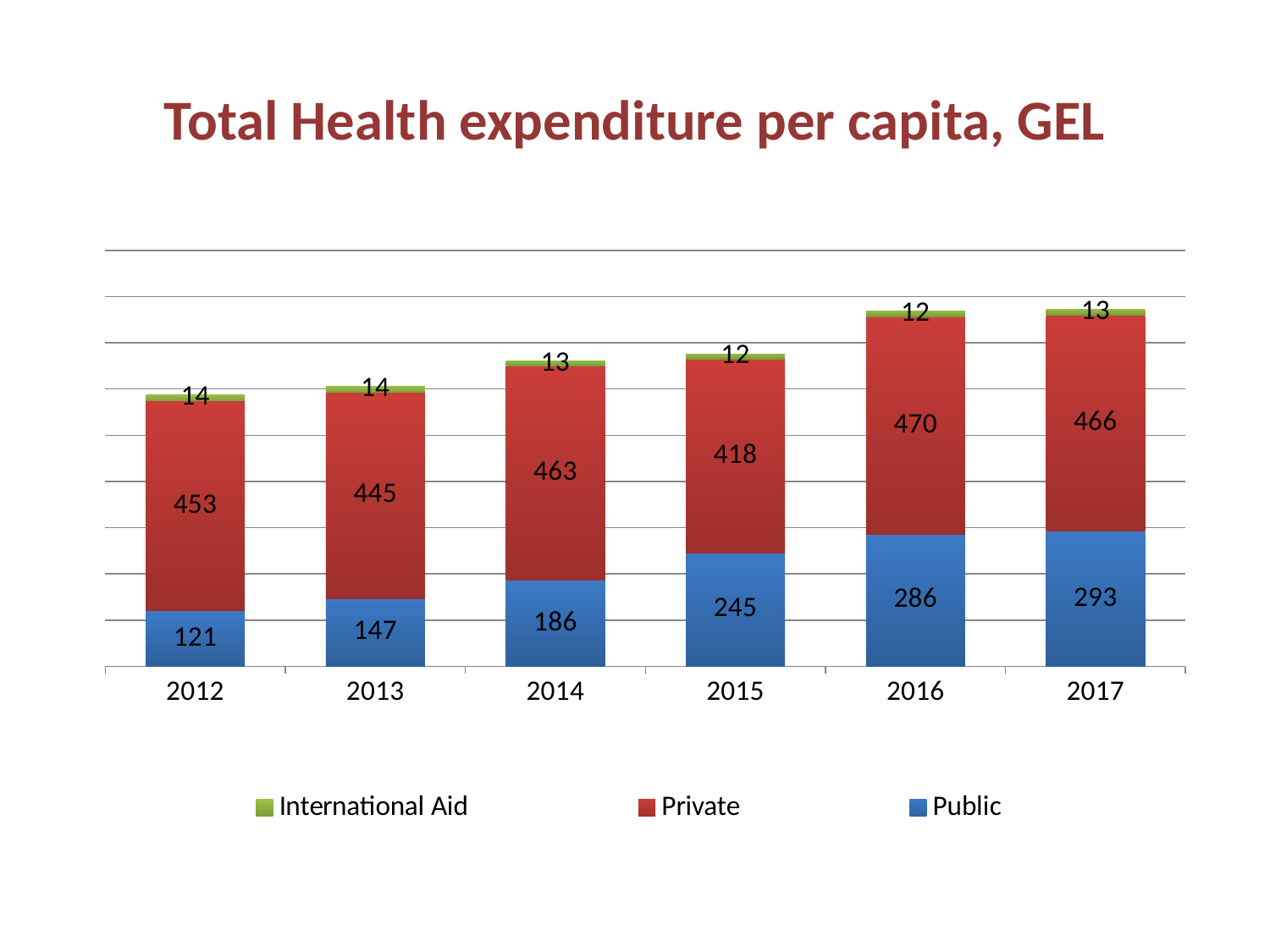
Do the Public values rise or fall from 2012 to 2017? Rise What is the Private value for 2013? 445 What is the total of the stacked bar for 2016? 768 How many years are shown on the x axis? 6 Which year has the highest Public value? 2017 How many series does the legend list? 3 What is the difference between the Public values for 2017 and 2012? 172 Which is larger, the Private value for 2014 or the Private value for 2016? 2016 Which year has the lowest Private value? 2015 What is the International Aid value for 2016? 12 What is the Public value for 2015? 245 What kind of chart is shown? Stacked bar chart